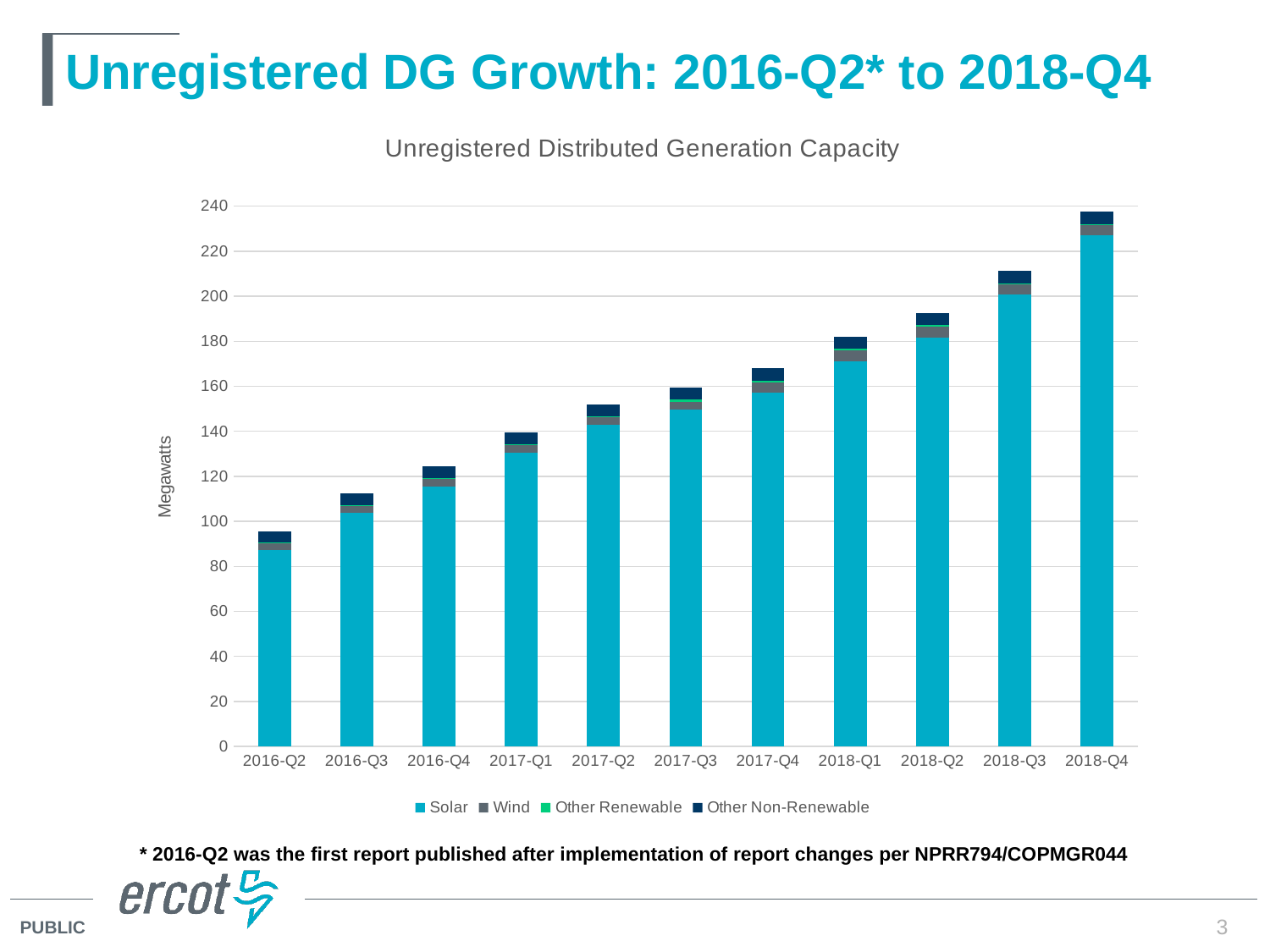
What unit is shown on the y axis? Megawatts Which quarter has the lowest total unregistered DG capacity? 2016-Q2 Is the total capacity for 2016-Q2 greater or less than 100 megawatts? less Which quarter has the highest total unregistered DG capacity? 2018-Q4 Is the total capacity for 2018-Q4 greater or less than 220 megawatts? greater Is the total capacity for 2018-Q3 greater or less than 200 megawatts? greater Do the total capacity values rise or fall from 2016-Q2 to 2018-Q4? Rise What kind of chart is shown on the slide? Stacked bar chart What is the title of the chart? Unregistered Distributed Generation Capacity How many series does the legend list? 4 How many quarters are shown on the x axis? 11 Which is larger, the total capacity for 2017-Q1 or for 2018-Q1? 2018-Q1